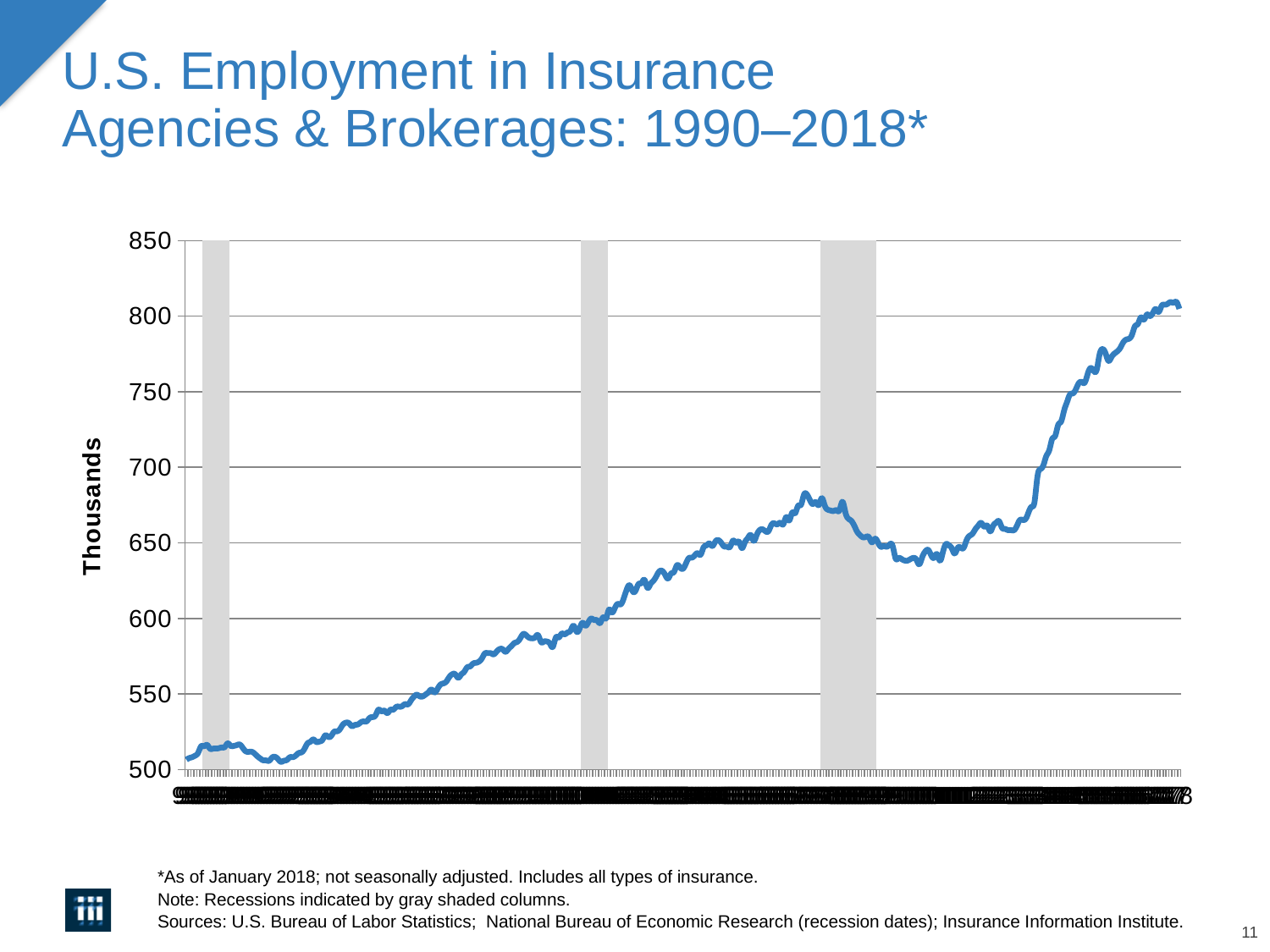
Which is larger: the value at the right end of the line or the value at the left end of the line? the right end Overall, do the values rise or fall from the left end of the chart to the right end? rise What is the label on the vertical axis of the chart? Thousands What is the title of the chart on the slide? U.S. Employment in Insurance Agencies & Brokerages: 1990–2018* Is the peak of the line just before the third gray shaded column greater or less than 700? less How many data series are plotted on the chart? 1 Is the lowest value reached by the line greater or less than 550? less What kind of chart is shown on the slide? line chart Is the value at the left end of the line (the earliest point) greater or less than 550? less